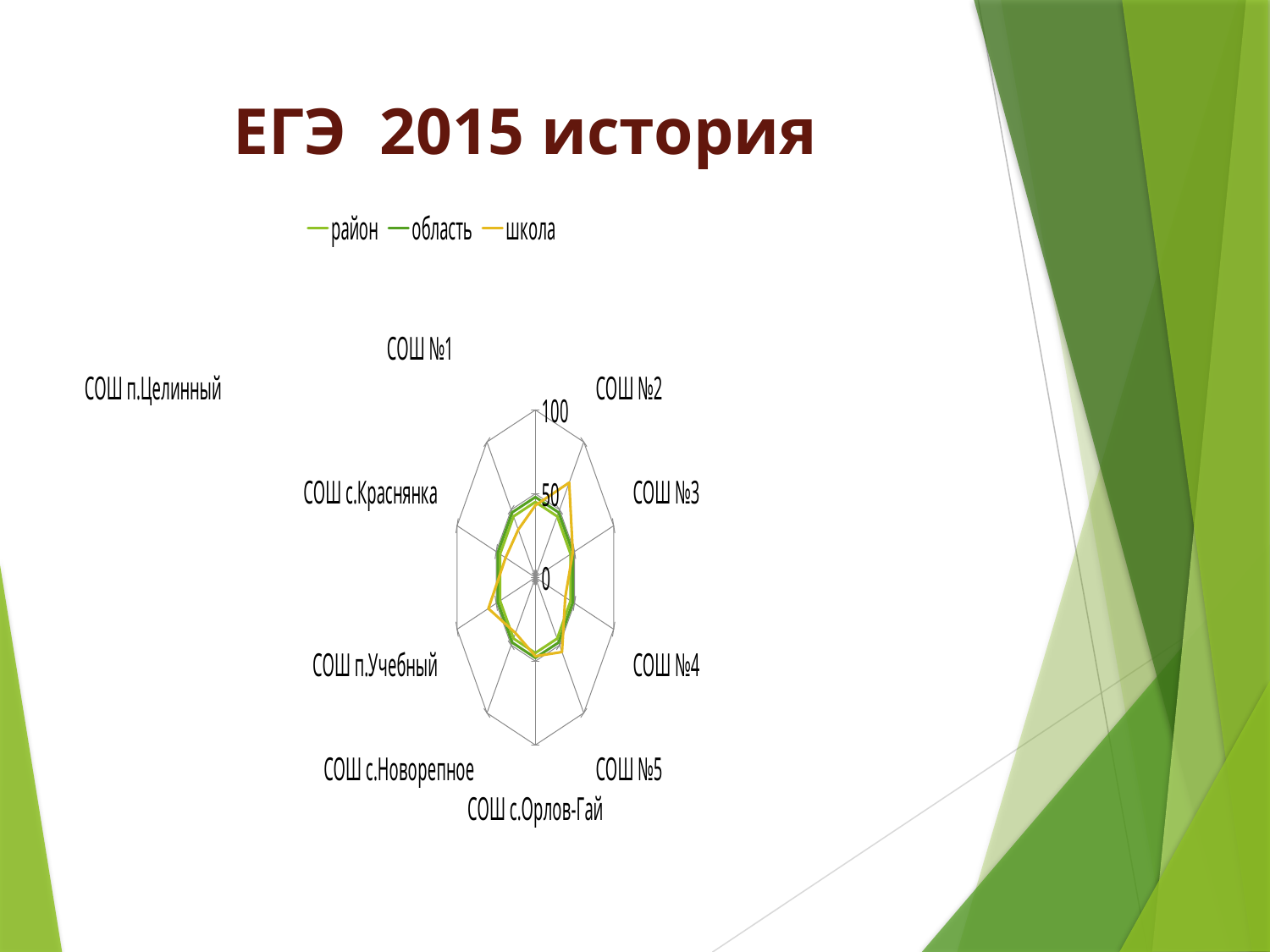
Is the value for школа at СОШ с.Краснянка greater or less than 50? less Is the value for район at СОШ №4 greater or less than 50? less How many series does the legend list? 3 Is the value for школа at СОШ №2 greater or less than 50? greater What is the highest value shown on the chart's axis? 100 What are the series names listed in the legend? район, область, школа What kind of chart is shown on the slide? radar chart What is the title of the slide above the chart? ЕГЭ 2015 история